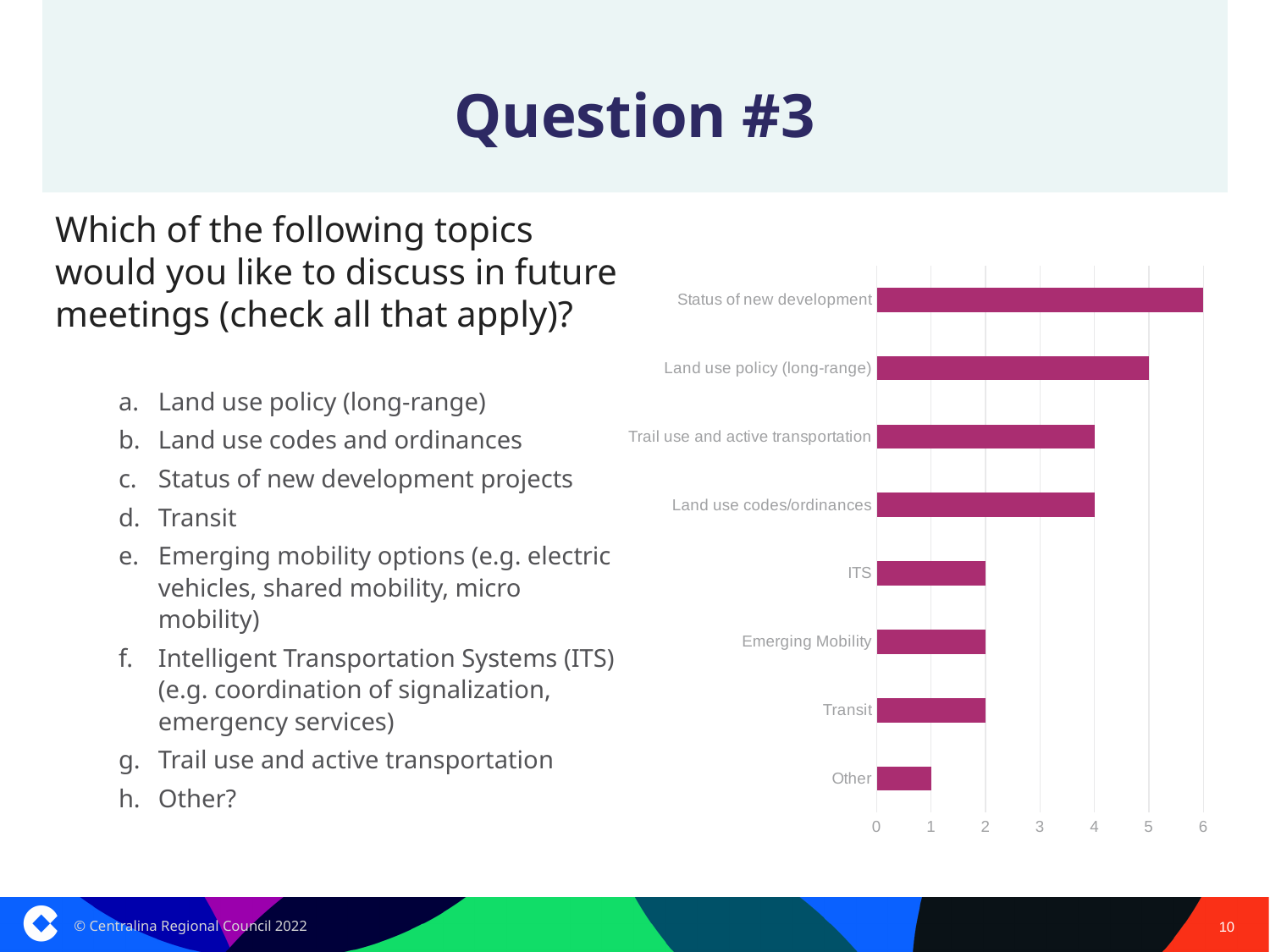
What is the value for Trail use and active transportation? 4 Which category has the lowest value in the chart? Other What is the value for Land use policy (long-range)? 5 Which is larger, the value for Land use policy (long-range) or the value for ITS? Land use policy (long-range) What is the maximum value shown on the horizontal axis of the chart? 6 What type of chart is shown on the slide? bar chart Is the value for Land use codes/ordinances greater or less than 3? greater Which category has the highest value in the chart? Status of new development What is the difference between the values for Status of new development and Other? 5 How many categories are plotted in the chart? 8 What is the value for Status of new development? 6 What is the value for Transit? 2